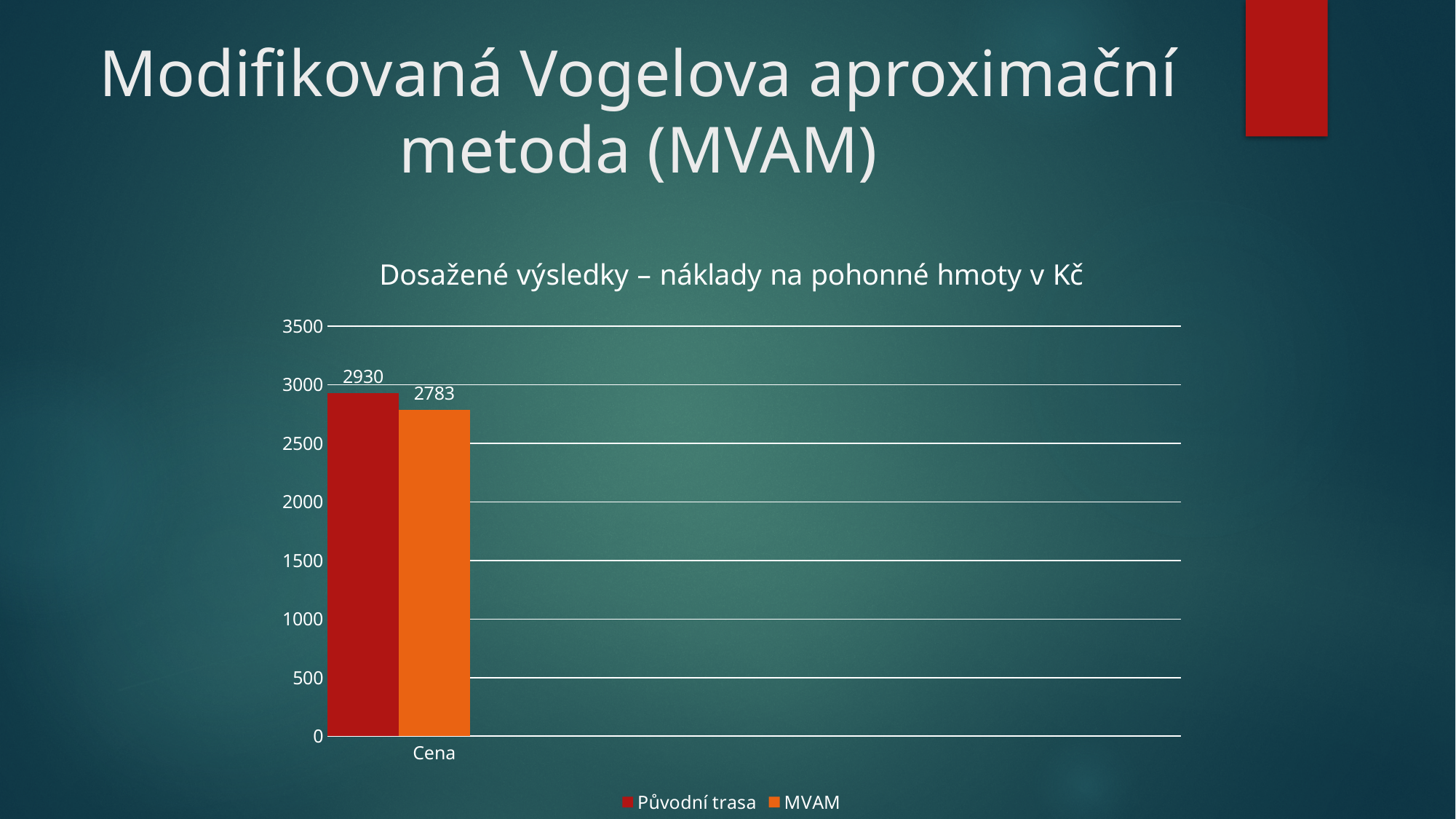
What is the difference between the Původní trasa value and the MVAM value? 147 Is the value for MVAM greater or less than 3000? less What is the value for Původní trasa? 2930 What kind of chart is shown on the slide? bar chart How many series does the legend list? 2 Which series has the lowest value? MVAM Is the value for Původní trasa greater or less than 2500? greater What is the label of the category on the x axis? Cena Which series has the higher value, Původní trasa or MVAM? Původní trasa How many categories are shown on the x axis? 1 What is the title of the chart? Dosažené výsledky – náklady na pohonné hmoty v Kč What is the value for MVAM? 2783